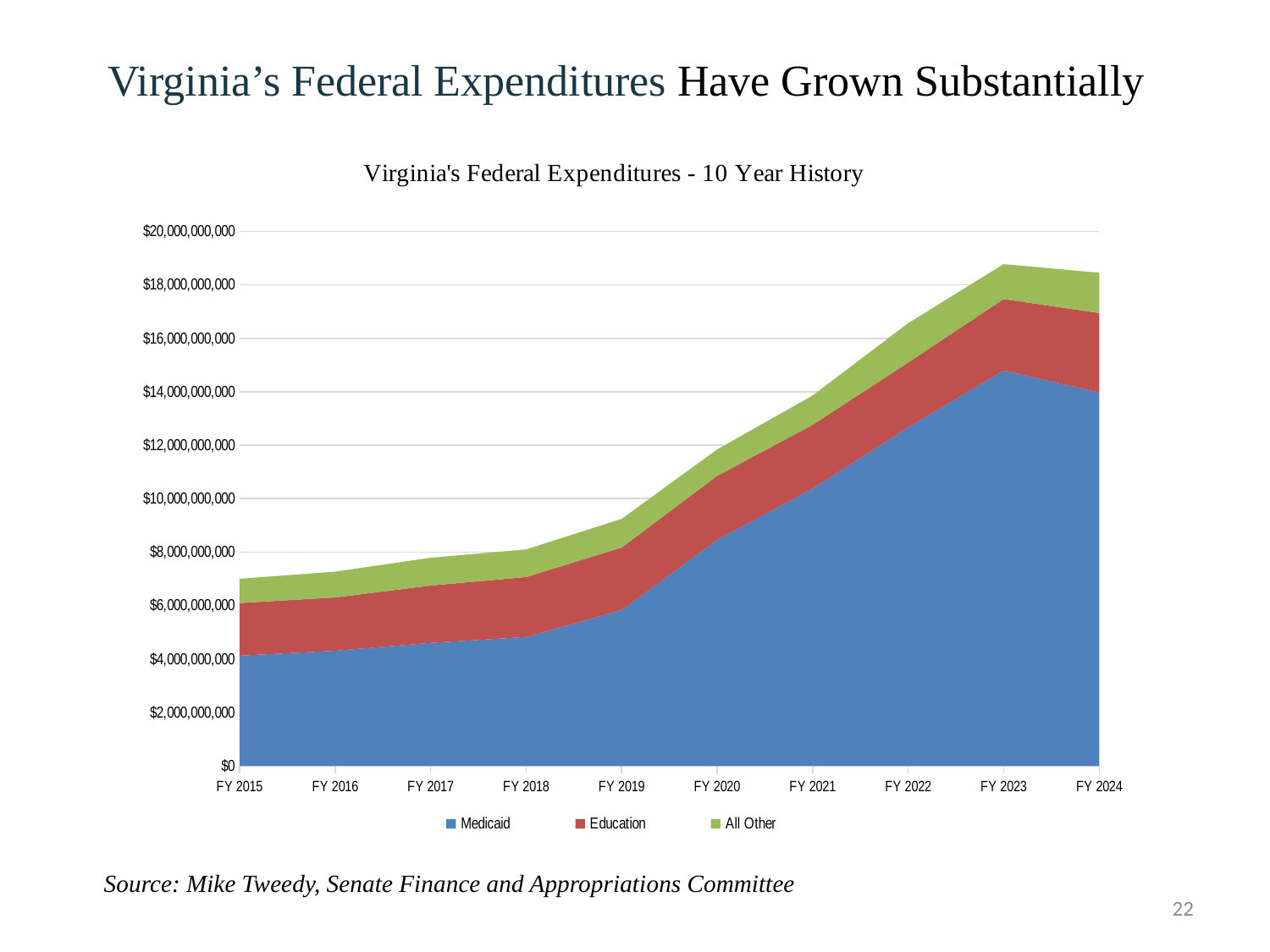
Which fiscal year has the highest total federal expenditures? FY 2023 What is the title of the chart? Virginia's Federal Expenditures - 10 Year History Which fiscal year has the lowest total federal expenditures? FY 2015 Do total federal expenditures generally rise or fall from FY 2015 to FY 2023? rise Which series accounts for the largest share of federal expenditures in every year shown? Medicaid What kind of chart is shown on the slide? Stacked area chart Is the Medicaid value for FY 2015 greater or less than $6,000,000,000? less How many series does the legend list? 3 Is the Medicaid value for FY 2024 greater or less than $12,000,000,000? greater Is the total federal expenditure for FY 2015 greater or less than $8,000,000,000? less Which series is shown in blue in the legend? Medicaid How many fiscal years are shown on the x axis? 10